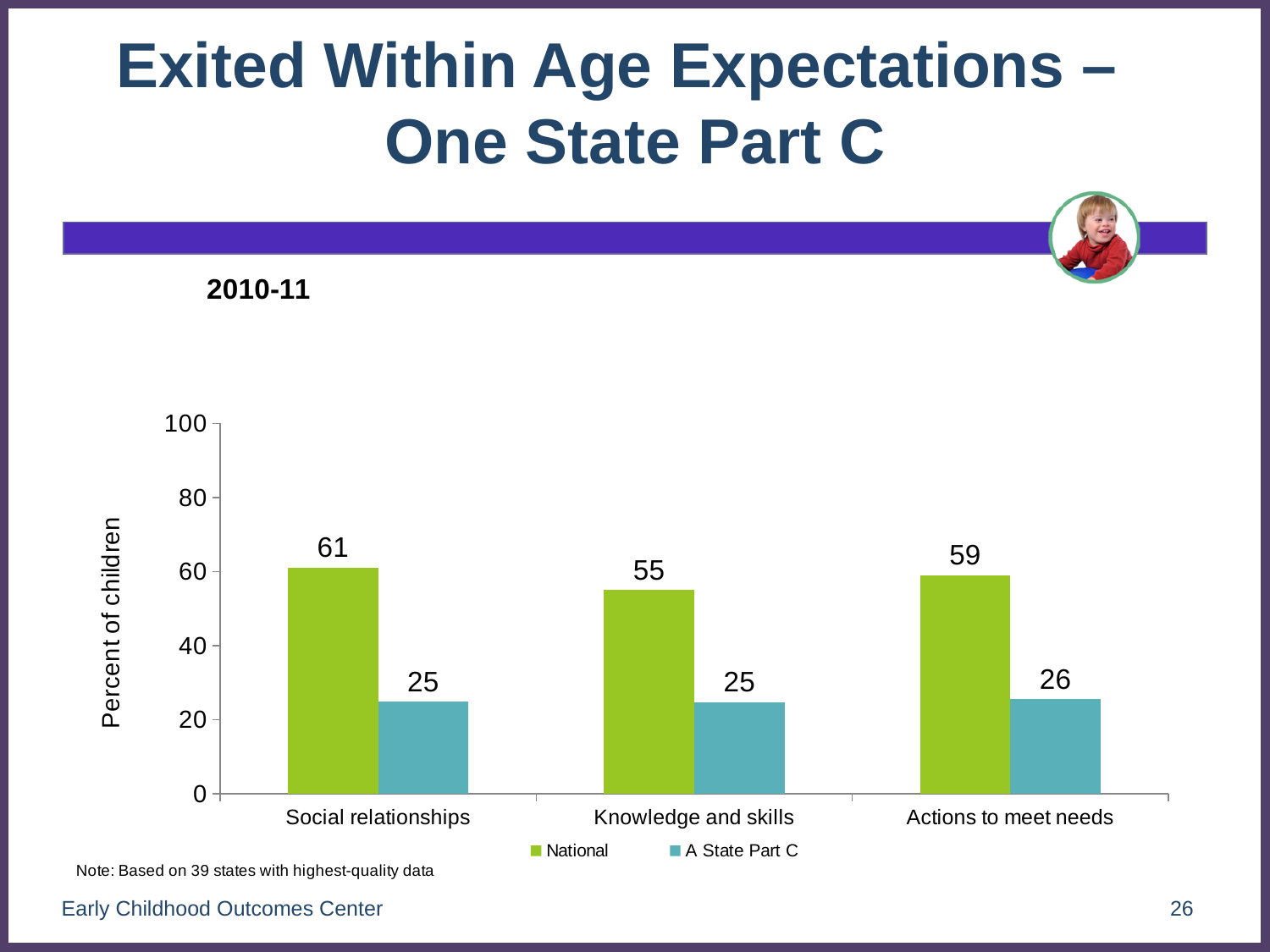
Which category has the lowest National value? Knowledge and skills How many series does the legend list? 2 What is the difference between the National and A State Part C values for Social relationships? 36 What is the National value for Social relationships? 61 What is the difference between the National values for Social relationships and Actions to meet needs? 2 What kind of chart is shown on the slide? Bar chart What is the label of the y axis? Percent of children Which is larger for Knowledge and skills: the National value or the A State Part C value? National How many categories are shown on the x axis? 3 What is the National value for Knowledge and skills? 55 What is the A State Part C value for Actions to meet needs? 26 Which category has the highest National value? Social relationships